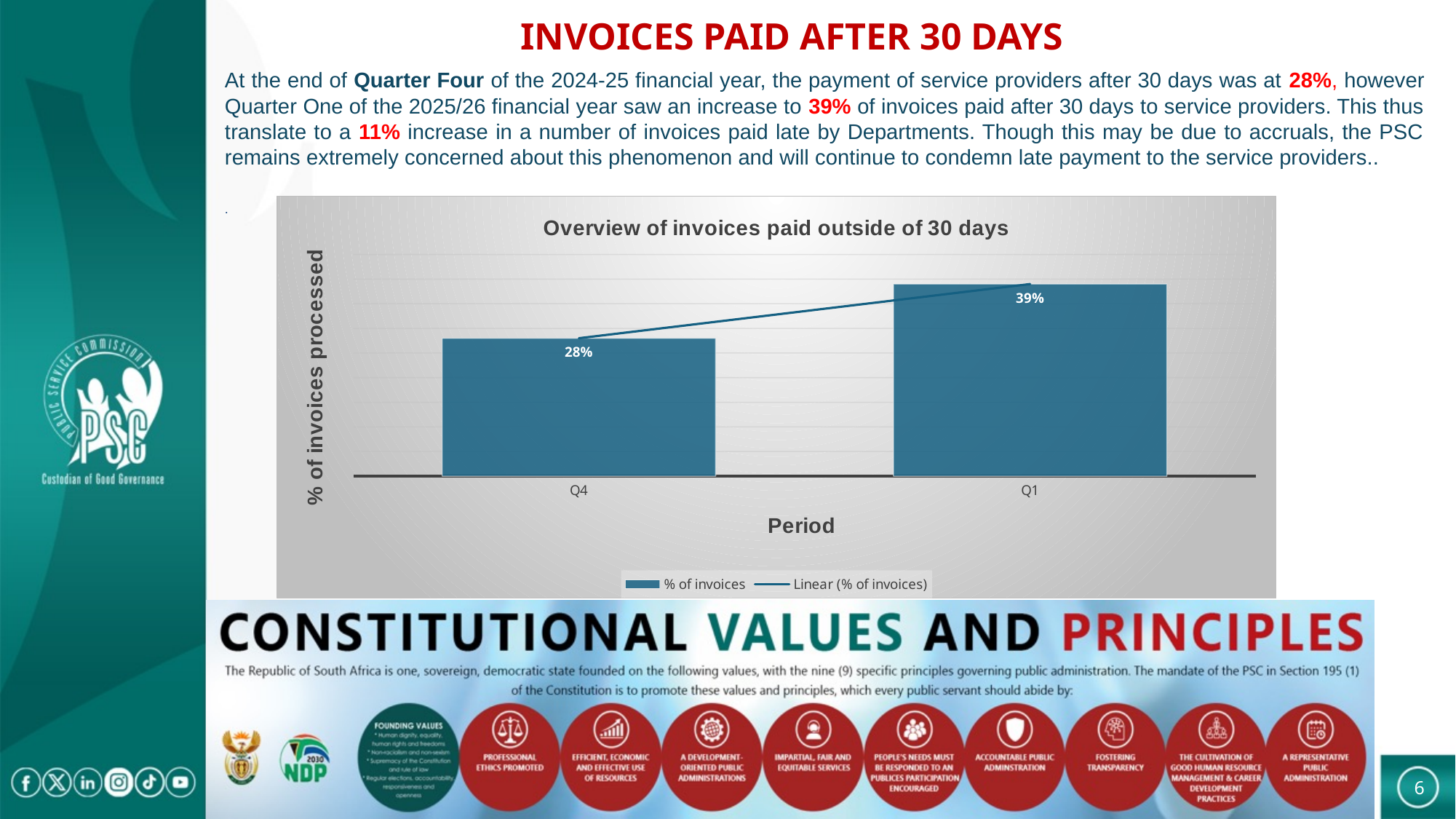
What is the value for Q4 in the chart? 28% What is the title of the chart? Overview of invoices paid outside of 30 days Which period has the lowest percentage of invoices paid outside of 30 days? Q4 What is the value for Q1 in the chart? 39% Do the values rise or fall from Q4 to Q1? Rise What kind of chart is shown on the slide? Bar chart How many entries does the chart legend list? 2 What is the difference between the Q1 and Q4 values? 11% What is the label of the x axis of the chart? Period How many periods are shown on the x axis of the chart? 2 Which is larger, the value for Q4 or the value for Q1? Q1 Which period has the highest percentage of invoices paid outside of 30 days? Q1